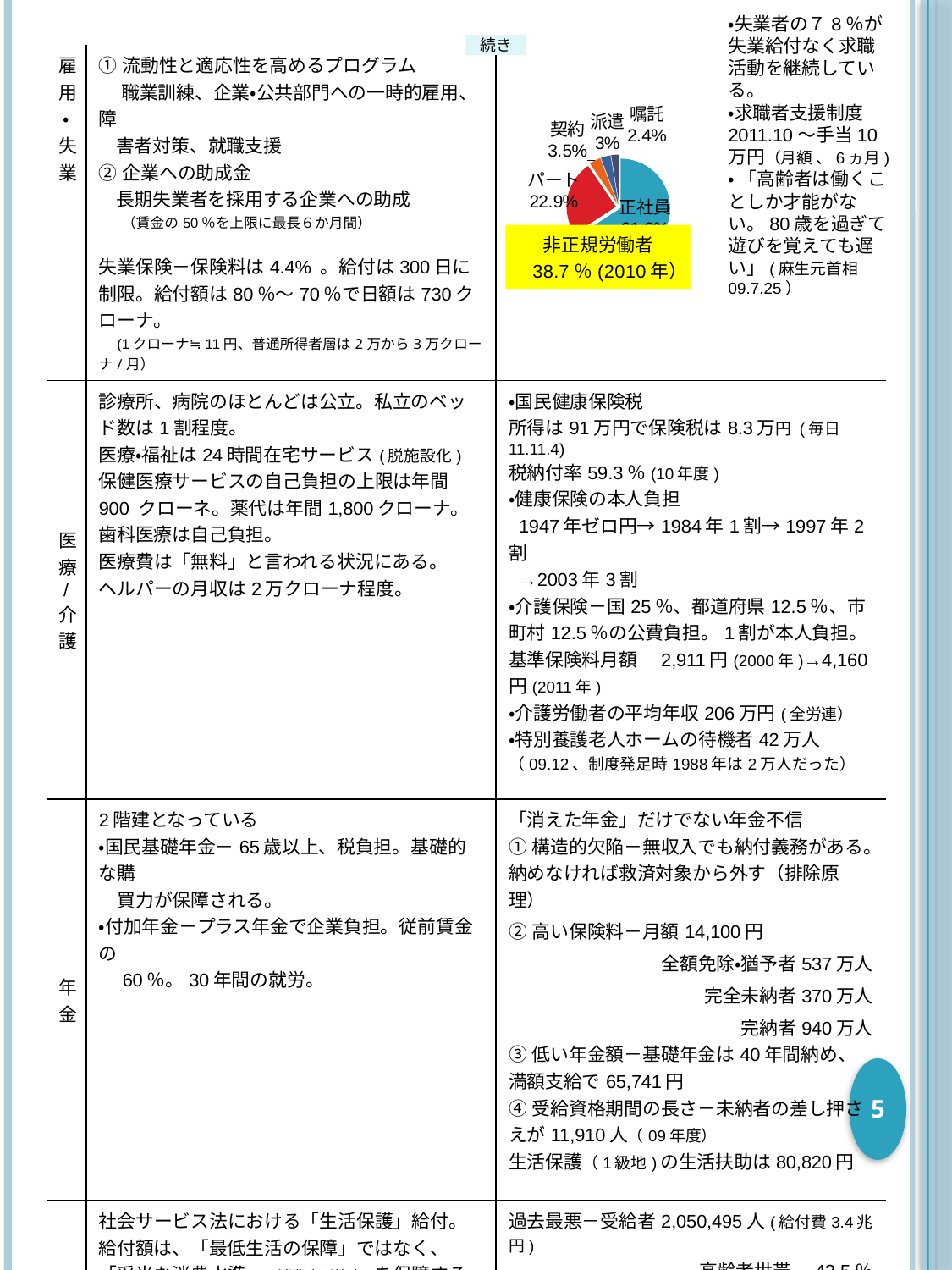
What share of 非正規労働者 does the yellow box over the pie chart state, and for which year? 38.7% (2010年) What is the value shown for 嘱託 in the pie chart? 2.4% Which is larger in the pie chart, パート or 契約? パート What is the difference between the 契約 and 派遣 values in the pie chart? 0.5% Which category has the largest slice in the pie chart? 正社員 How many slices does the pie chart have? 5 Which category has the smallest slice in the pie chart? 嘱託 What kind of chart is shown on the slide? pie chart What is the value shown for 派遣 in the pie chart? 3% What is the difference between the パート and 嘱託 values in the pie chart? 20.5% What is the value shown for パート in the pie chart? 22.9% What is the value shown for 契約 in the pie chart? 3.5%